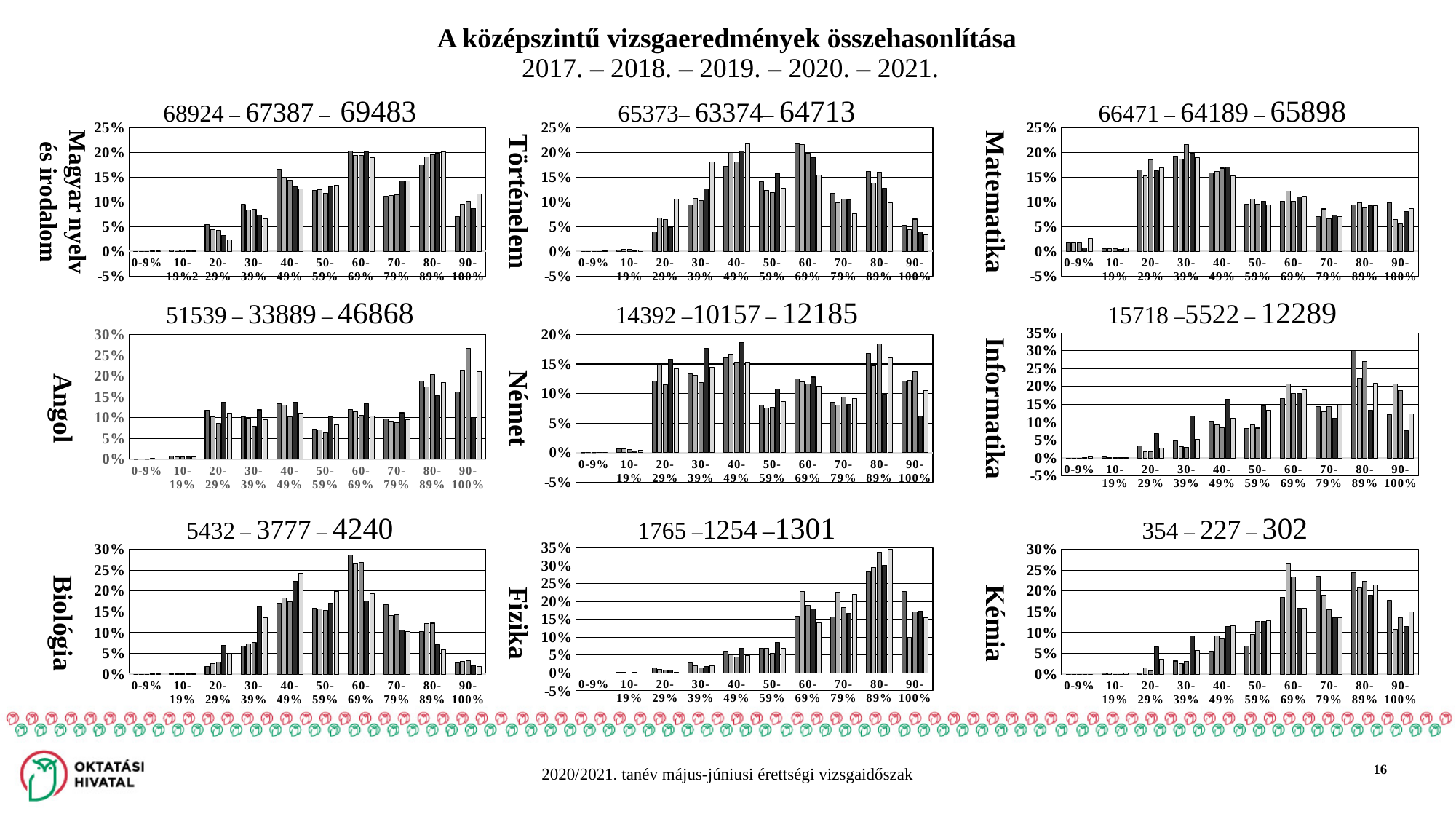
In the Fizika chart (bottom middle), is the tallest bar in the 80-89% group greater or less than 30%? greater In the Biológia chart (bottom left), is the tallest bar in the 60-69% group greater or less than 25%? greater How many score-band categories are shown on the x axis of the Biológia chart (bottom left)? 10 In the Informatika chart (middle right), is the tallest bar in the 80-89% group greater or less than 25%? greater How many charts are shown on the slide? 9 In the Matematika chart (top right), which score band has the tallest bar? 30-39% In the Fizika chart (bottom middle), which score band has the tallest bar? 80-89% In the Biológia chart (bottom left), which score band has the tallest bar? 60-69% What kind of chart is the Magyar nyelv és irodalom chart (top left)? bar chart